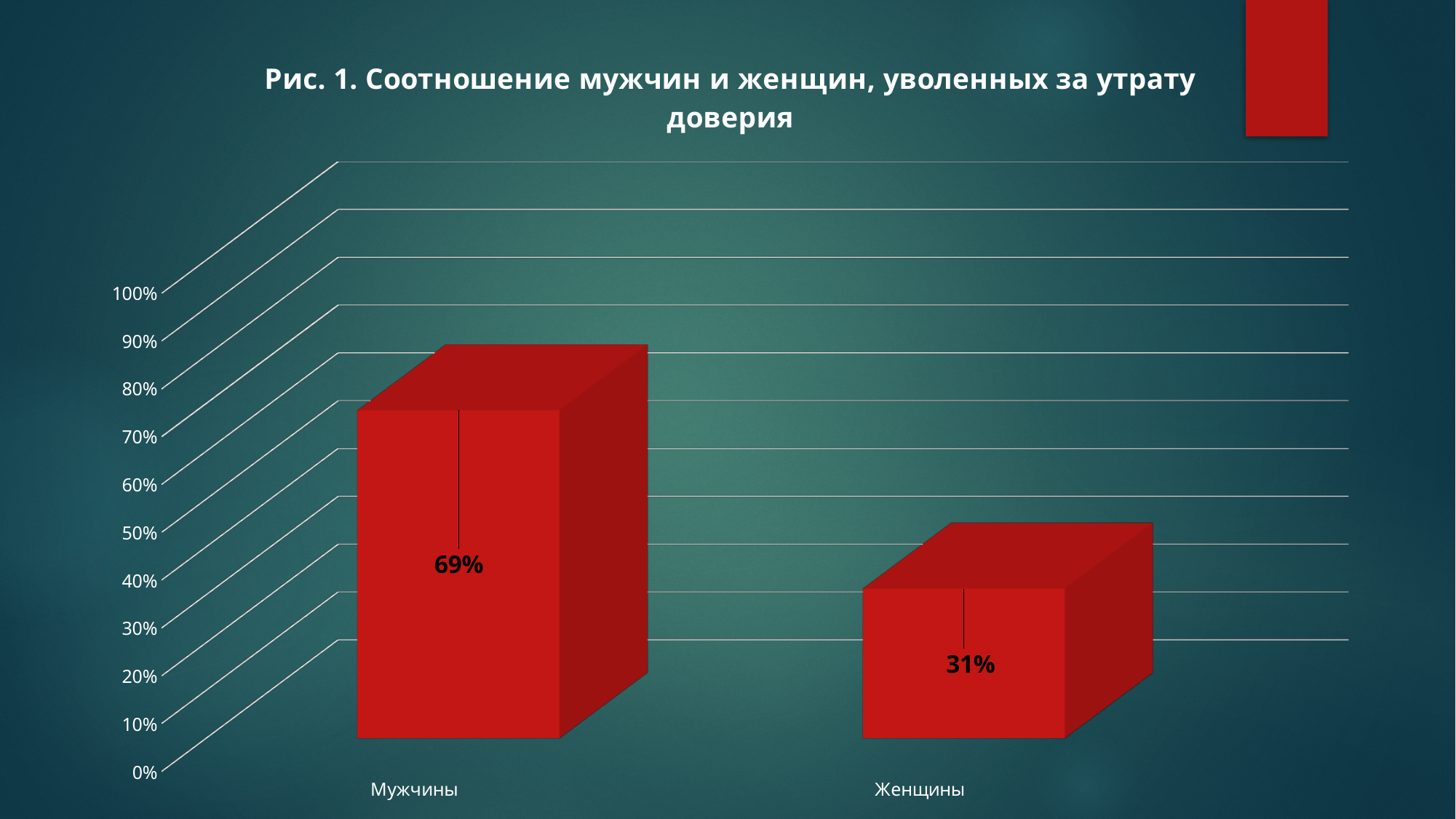
How many categories are shown on the chart? 2 What kind of chart is shown on the slide? bar chart Is the value for Женщины greater or less than 40%? less What is the value for Женщины? 31% Is the value for Мужчины greater or less than 60%? greater Which is larger, the value for Мужчины or the value for Женщины? Мужчины What colour are the bars on the chart? red What is the difference between the values for Мужчины and Женщины? 38% What is the title of the chart? Рис. 1. Соотношение мужчин и женщин, уволенных за утрату доверия What is the value for Мужчины? 69% Which category has the lowest value? Женщины Which category has the highest value? Мужчины